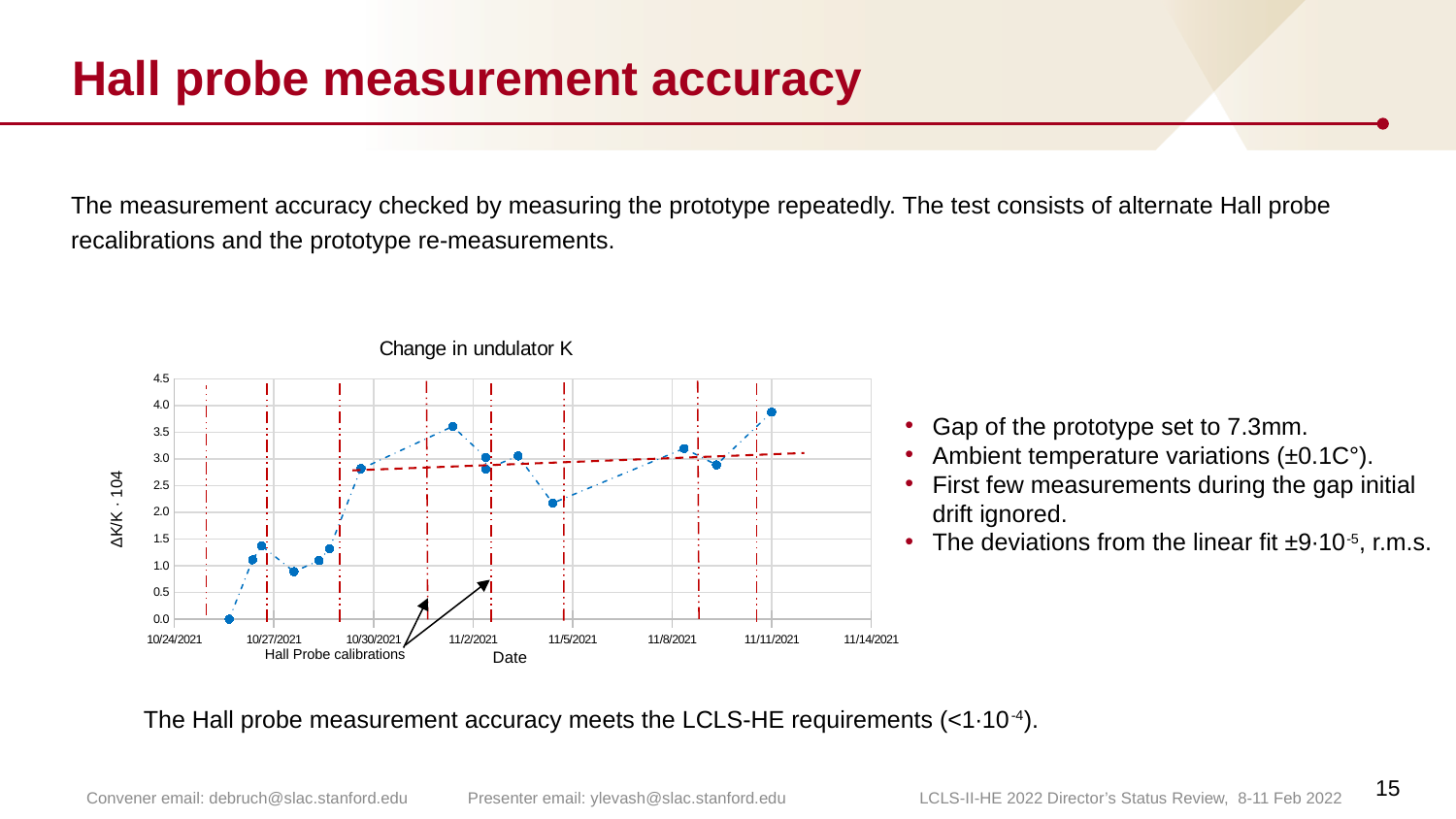
Is the value for the point on 11/4/2021 greater or less than 2.0? greater What is the value of the first plotted point (around 10/25/2021)? 0.0 What is the title of the chart? Change in undulator K What kind of chart is shown on the slide? line chart Which date has the highest plotted value? 11/11/2021 Is the value for the point on 10/27/2021 greater or less than 2.0? less Do the plotted values generally rise or fall from 10/25/2021 to 11/11/2021? rise Which is larger, the value on 11/1/2021 or the value on 11/4/2021? 11/1/2021 What do the red dashed vertical lines in the chart mark? Hall Probe calibrations Is the value for the point on 11/11/2021 greater or less than 3.5? greater